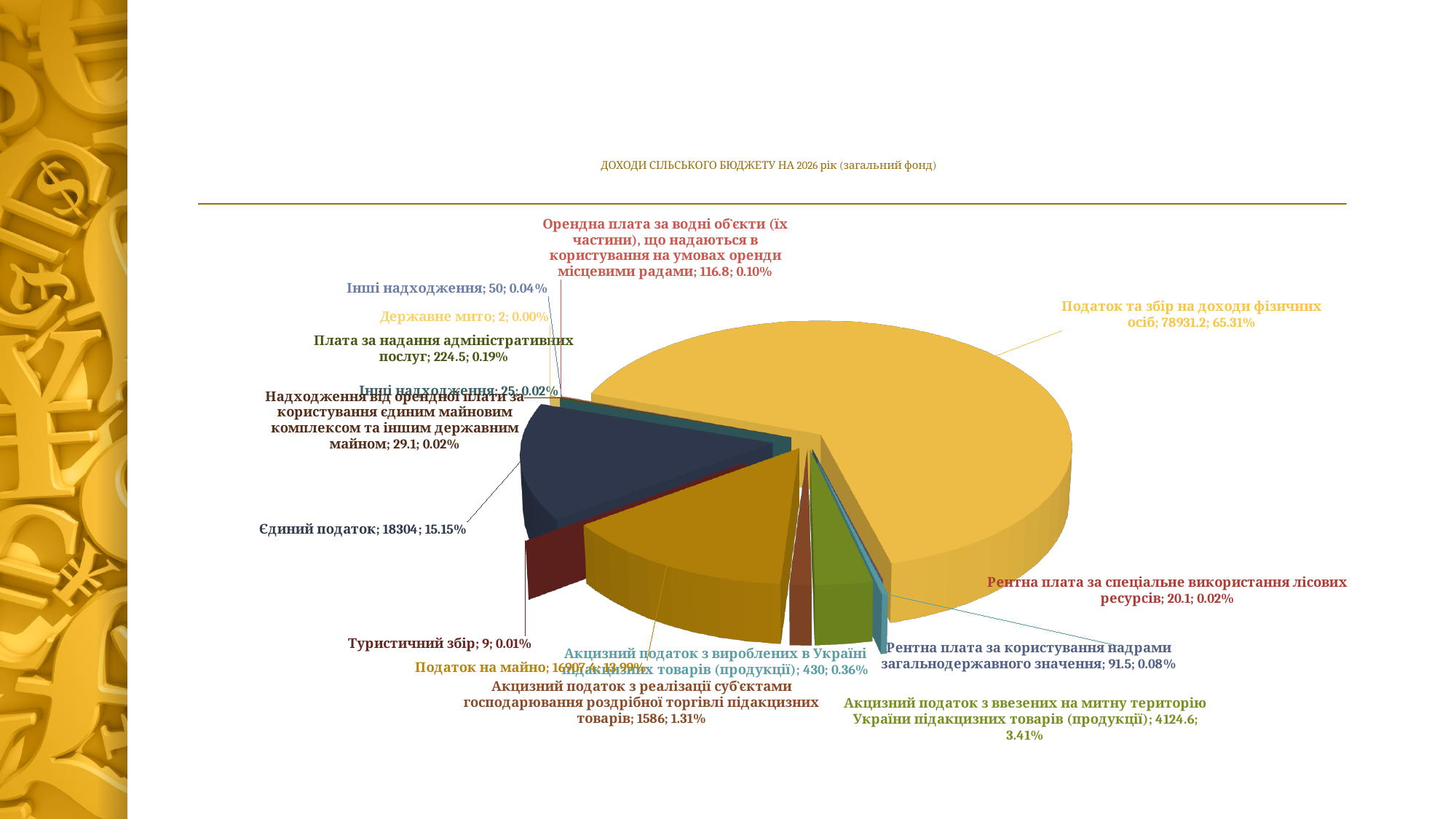
What is the title of the chart? ДОХОДИ СІЛЬСЬКОГО БЮДЖЕТУ НА 2026 рік (загальний фонд) What is the value for Плата за надання адміністративних послуг? 224.5 What is the difference between the values for Акцизний податок з реалізації суб'єктами господарювання роздрібної торгівлі підакцизних товарів and Акцизний податок з вироблених в Україні підакцизних товарів (продукції)? 1156 What share of the pie does Єдиний податок represent? 15.15% What is the value for Податок та збір на доходи фізичних осіб? 78931.2 What is the value for Єдиний податок? 18304 Which is larger: Туристичний збір or Рентна плата за спеціальне використання лісових ресурсів? Рентна плата за спеціальне використання лісових ресурсів What kind of chart is shown on the slide? pie chart What is the value for Акцизний податок з ввезених на митну територію України підакцизних товарів (продукції)? 4124.6 Which category has the largest slice of the pie? Податок та збір на доходи фізичних осіб Which category has the smallest value? Державне мито What share of the pie does Податок та збір на доходи фізичних осіб represent? 65.31%